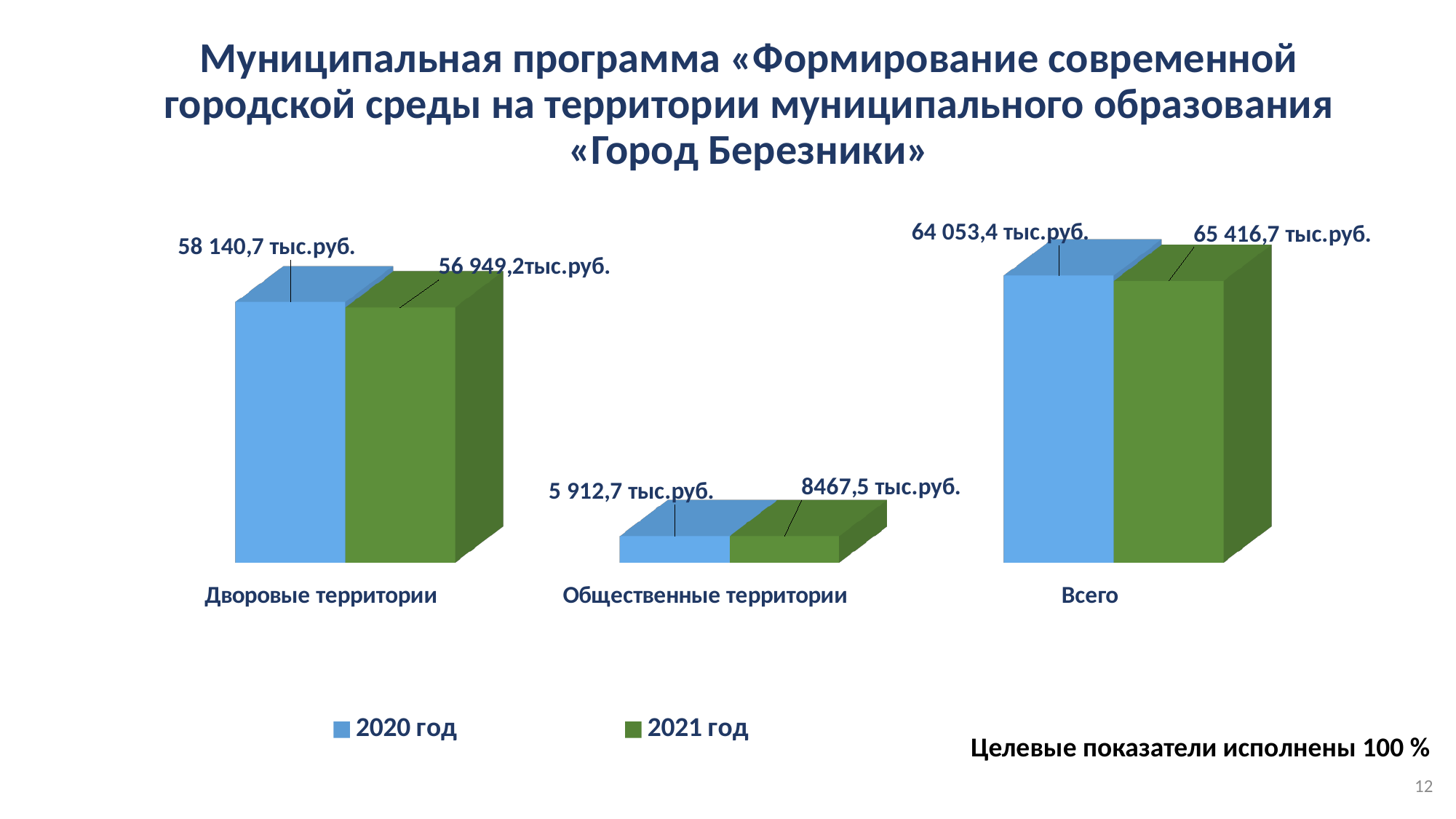
What is the difference between the 2021 год and 2020 год values for Общественные территории? 2 554,8 тыс.руб. What is the value for Общественные территории in 2021 год? 8467,5 тыс.руб. What is the value for Дворовые территории in 2020 год? 58 140,7 тыс.руб. Which category has the highest value in 2021 год? Всего How many series does the legend list? 2 How many categories are shown on the x axis? 3 What kind of chart is shown on the slide? Bar chart What is the value for Всего in 2021 год? 65 416,7 тыс.руб. Which category has the lowest value in 2020 год? Общественные территории What is the value for Общественные территории in 2020 год? 5 912,7 тыс.руб. What is the difference between the 2020 год and 2021 год values for Дворовые территории? 1 191,5 тыс.руб. Which is larger for Общественные территории: the 2020 год value or the 2021 год value? 2021 год